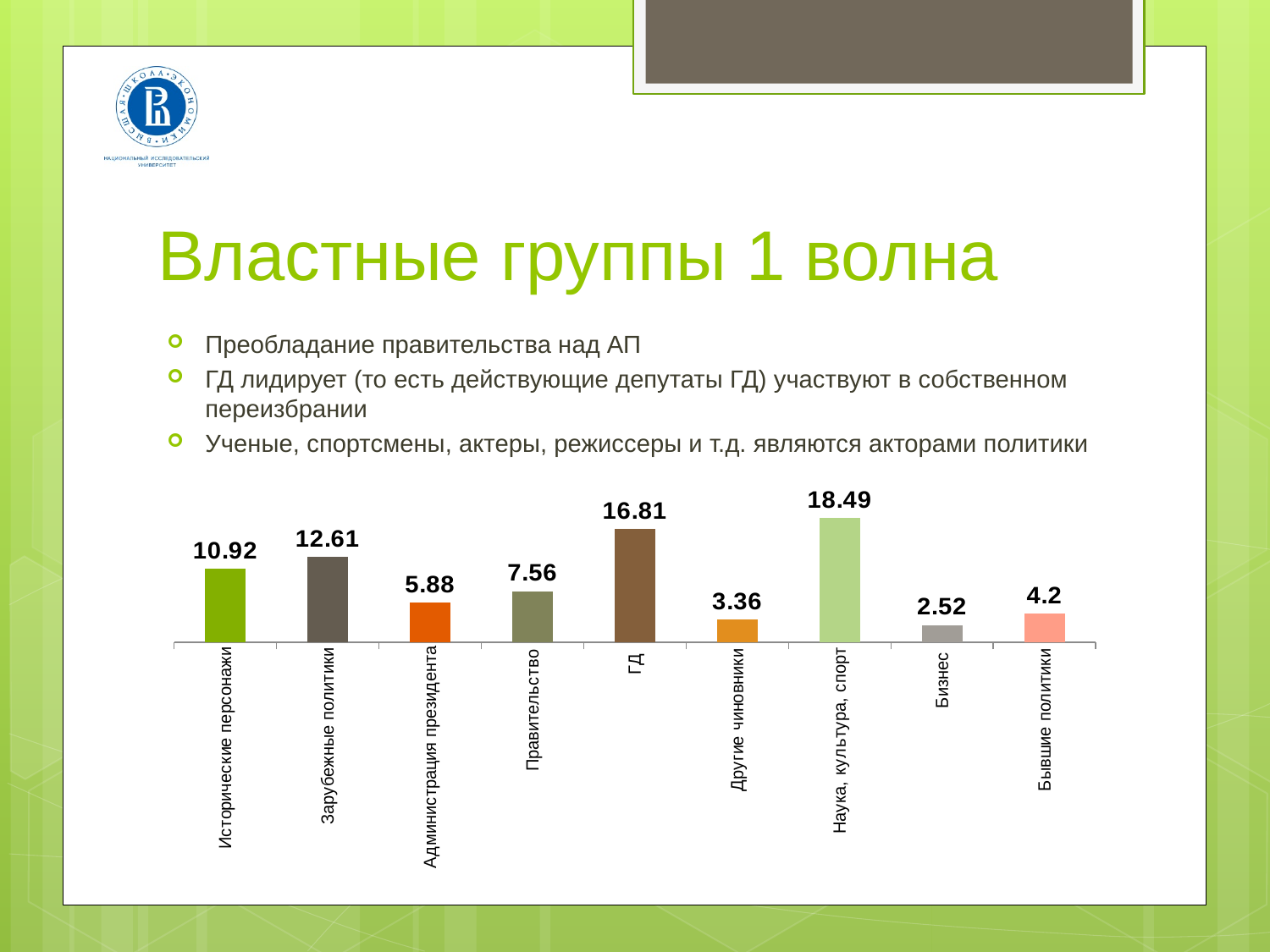
What is the difference between the values for Наука, культура, спорт and ГД? 1.68 What is the value for ГД? 16.81 How many categories are shown in the chart? 9 Which is larger, the value for Зарубежные политики or the value for Исторические персонажи? Зарубежные политики Which category has the lowest value? Бизнес What is the difference between the values for Правительство and Администрация президента? 1.68 What kind of chart is shown on the slide? Bar chart What is the value for Бизнес? 2.52 What is the value for Администрация президента? 5.88 Which is larger, the value for Бывшие политики or the value for Другие чиновники? Бывшие политики What is the value for Наука, культура, спорт? 18.49 Which category has the highest value? Наука, культура, спорт